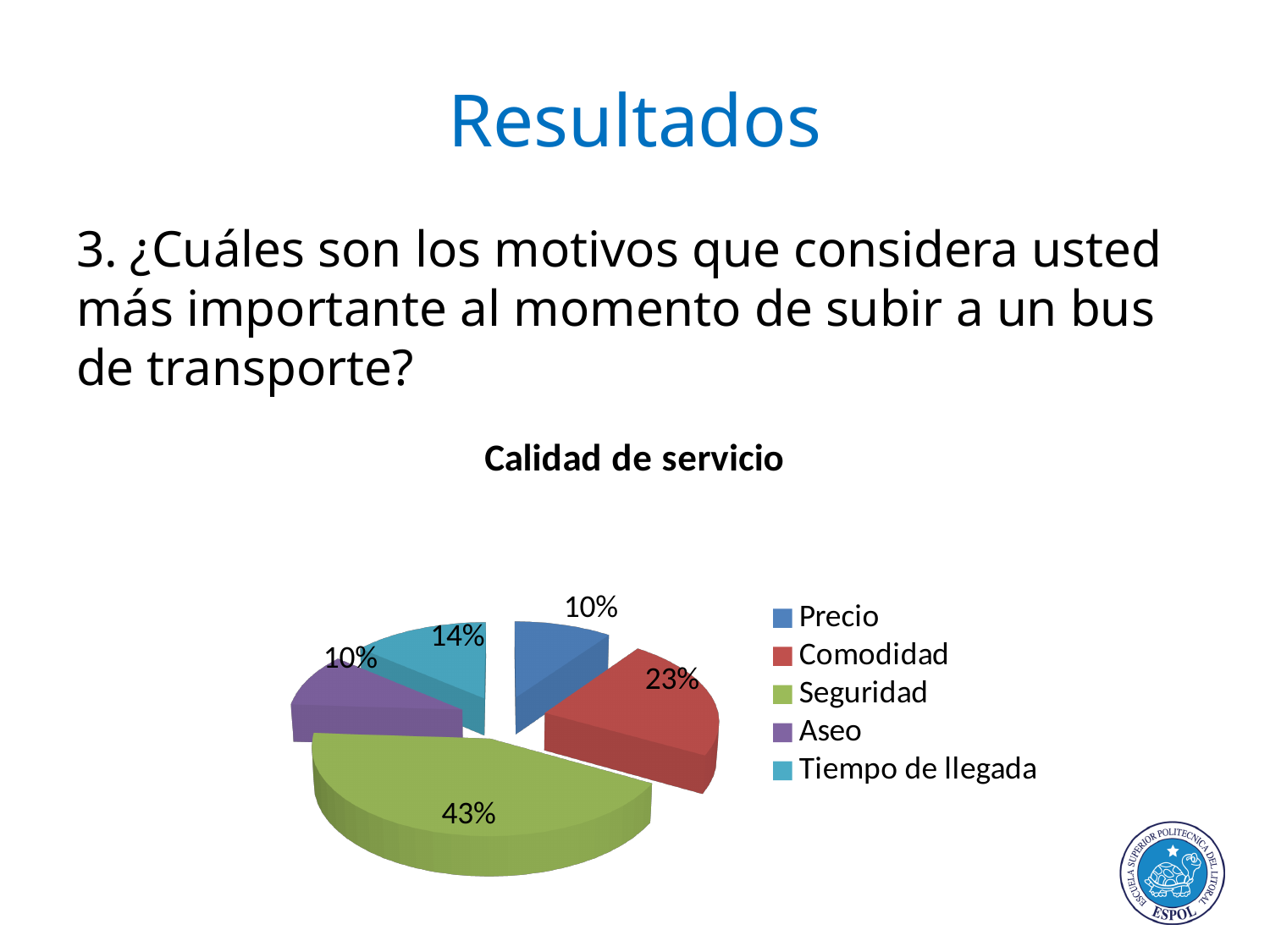
How many categories does the legend list? 5 What share of the pie does Precio have? 10% What is the title of the chart? Calidad de servicio Which category has the largest slice of the pie? Seguridad What colour is the Seguridad slice? green Which is larger, the share for Comodidad or the share for Tiempo de llegada? Comodidad Is the share for Seguridad greater or less than 40%? greater What kind of chart is shown on the slide? pie chart What share of the pie does Seguridad have? 43% What share of the pie does Comodidad have? 23% What is the difference in percentage points between the Seguridad share and the Comodidad share? 20